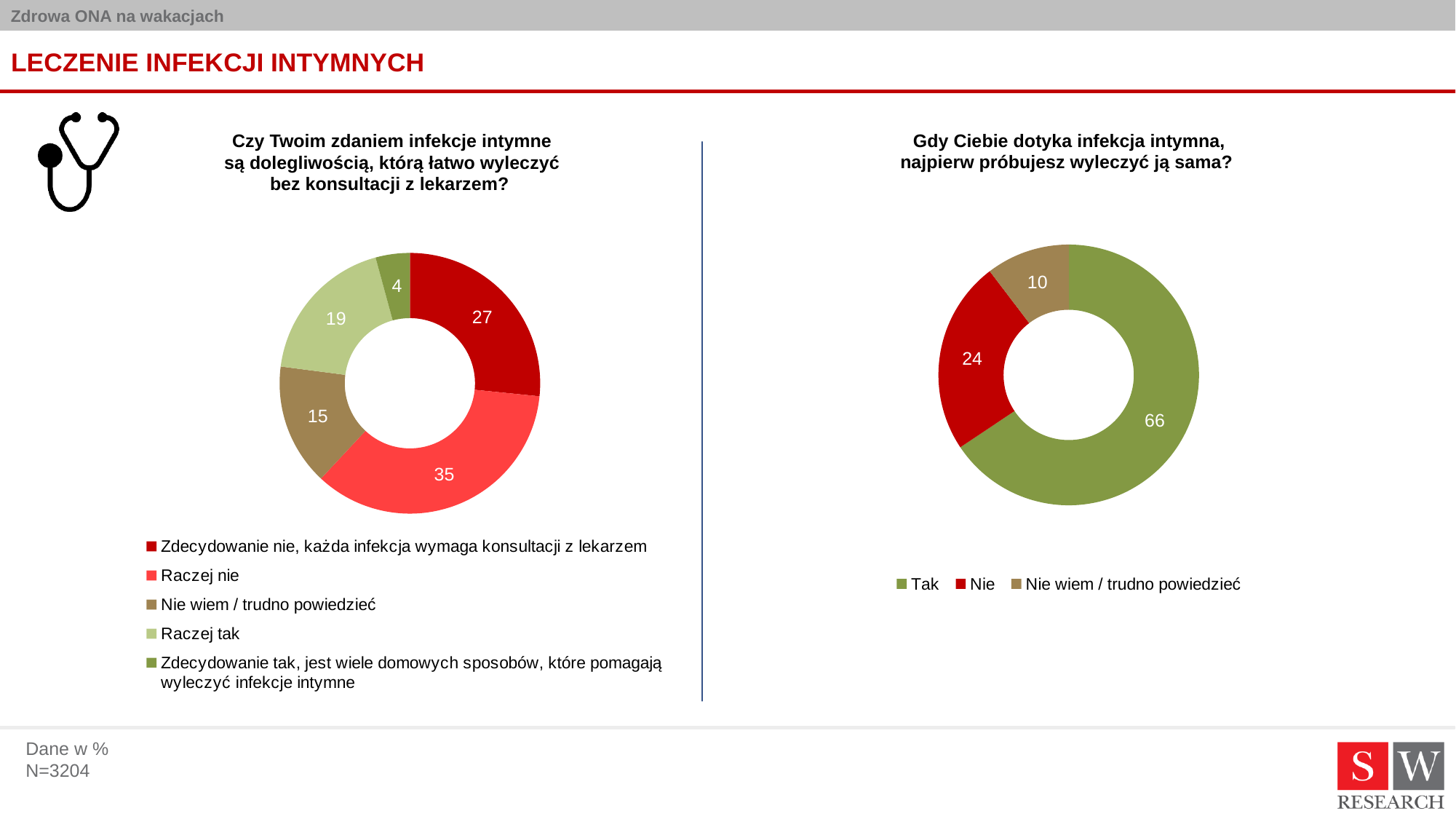
In the left chart, which category has the lowest value? Zdecydowanie tak, jest wiele domowych sposobów, które pomagają wyleczyć infekcje intymne In the right chart ("Gdy Ciebie dotyka infekcja intymna, najpierw próbujesz wyleczyć ją sama?"), what is the value for "Tak"? 66 In the left chart, what is the value for "Zdecydowanie nie, każda infekcja wymaga konsultacji z lekarzem"? 27 In the left chart, how many categories does the legend list? 5 In the left chart ("Czy Twoim zdaniem infekcje intymne są dolegliwością, którą łatwo wyleczyć bez konsultacji z lekarzem?"), what is the value for "Raczej nie"? 35 In the right chart, what is the difference between "Tak" and "Nie"? 42 In the right chart, what is the value for "Nie wiem / trudno powiedzieć"? 10 What type of chart is the right chart? Donut (pie) chart In the right chart, which is larger, "Tak" or "Nie"? Tak In the right chart, what colour is the "Nie" slice? Red In the left chart, what is the difference between "Raczej tak" and "Nie wiem / trudno powiedzieć"? 4 In the left chart, which category has the highest value? Raczej nie